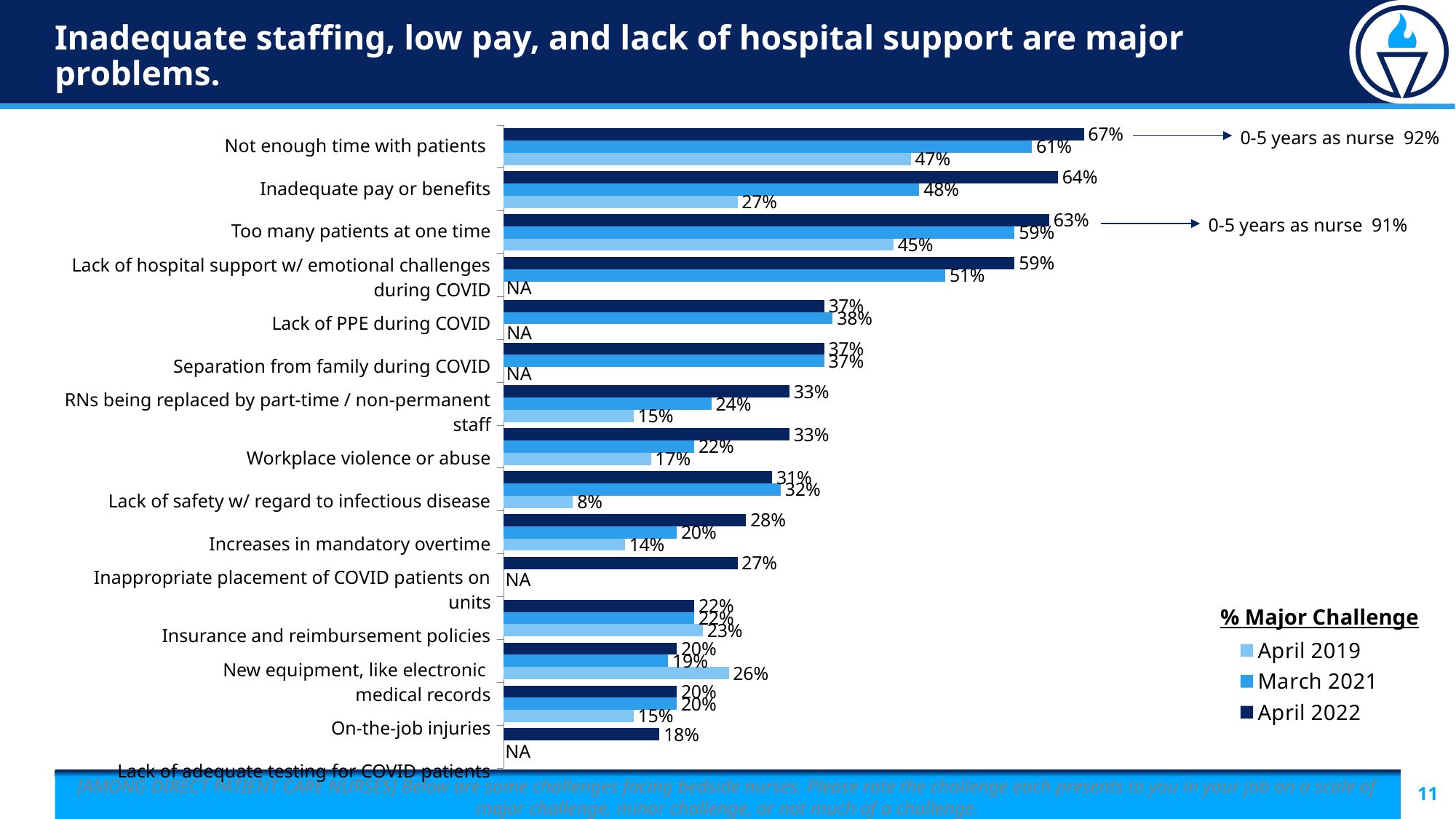
Which challenge has the highest April 2022 value? Not enough time with patients For Inadequate pay or benefits, do the values rise or fall from April 2019 to April 2022? rise What is the April 2019 value for Lack of safety w/ regard to infectious disease? 8% What kind of chart is shown on the slide? bar chart What is the March 2021 value for Too many patients at one time? 59% For Workplace violence or abuse, which is larger: the April 2022 value or the March 2021 value? April 2022 According to the annotation, what is the value for nurses with 0-5 years as nurse for Not enough time with patients? 92% What is the difference between the April 2022 and April 2019 values for Inadequate pay or benefits? 37 percentage points How many series does the legend list? 3 What is the April 2022 value for Inadequate pay or benefits? 64% What is the title of the legend? % Major Challenge What is the April 2019 value for New equipment, like electronic medical records? 26%